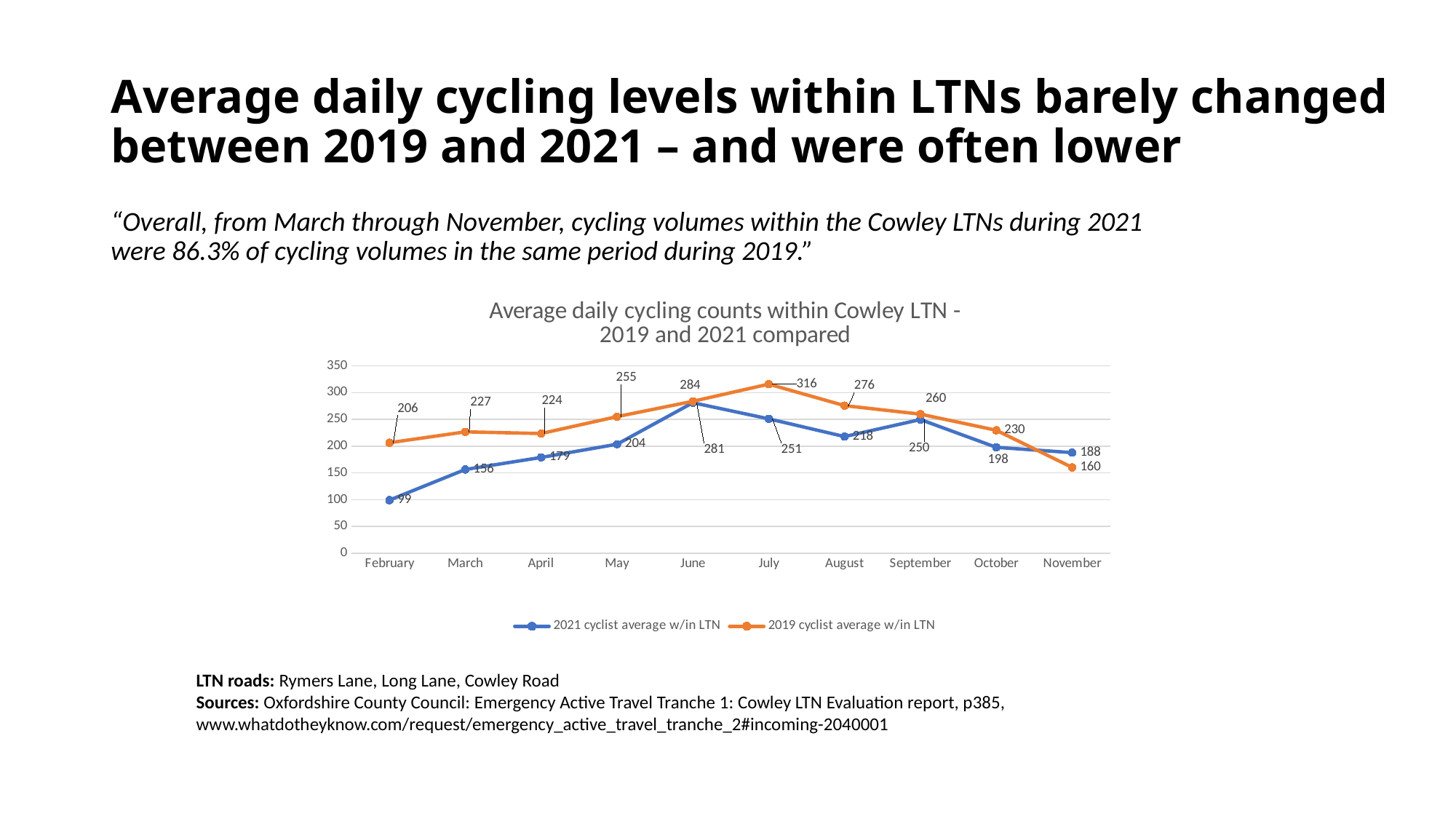
What kind of chart is shown on the slide? Line chart What is the 2021 cyclist average within the LTN for September? 250 In November, which series has the higher value: 2021 or 2019 cyclist average within the LTN? 2021 cyclist average w/in LTN In which month is the 2021 cyclist average within the LTN lowest? February In which month is the 2019 cyclist average within the LTN lowest? November What is the difference between the 2019 and 2021 cyclist averages in July? 65 How many series does the legend list? 2 In which month is the 2019 cyclist average within the LTN highest? July What is the 2019 cyclist average within the LTN for July? 316 Does the 2021 cyclist average within the LTN rise or fall from February to June? Rise What is the 2021 cyclist average within the LTN for February? 99 How many months are shown on the x axis? 10